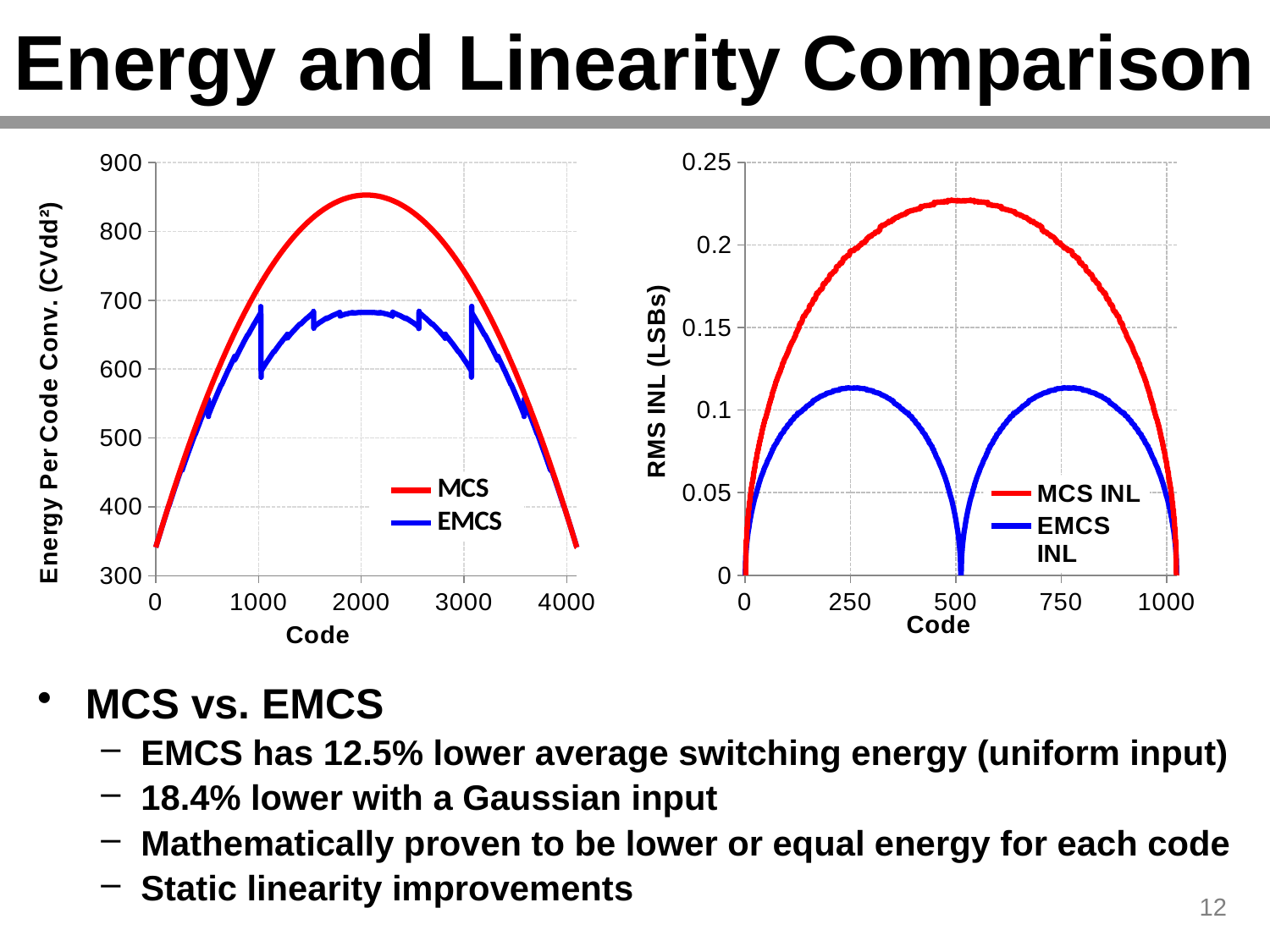
What is the y-axis label of the right chart? RMS INL (LSBs) How many series does the legend of the left chart list? 2 In the left chart, is the peak value of the EMCS series greater or less than 700? less In the left chart, is the peak value of the MCS series greater or less than 800? greater In the left chart, at code 2000, which series has the higher energy, MCS or EMCS? MCS How many series does the legend of the right chart list? 2 In the right chart, is the peak value of the MCS INL series greater or less than 0.2? greater In the right chart, which series reaches the higher maximum RMS INL, MCS INL or EMCS INL? MCS INL What kind of chart is the right chart (RMS INL vs Code)? line chart What kind of chart is the left chart (Energy Per Code Conv. vs Code)? line chart